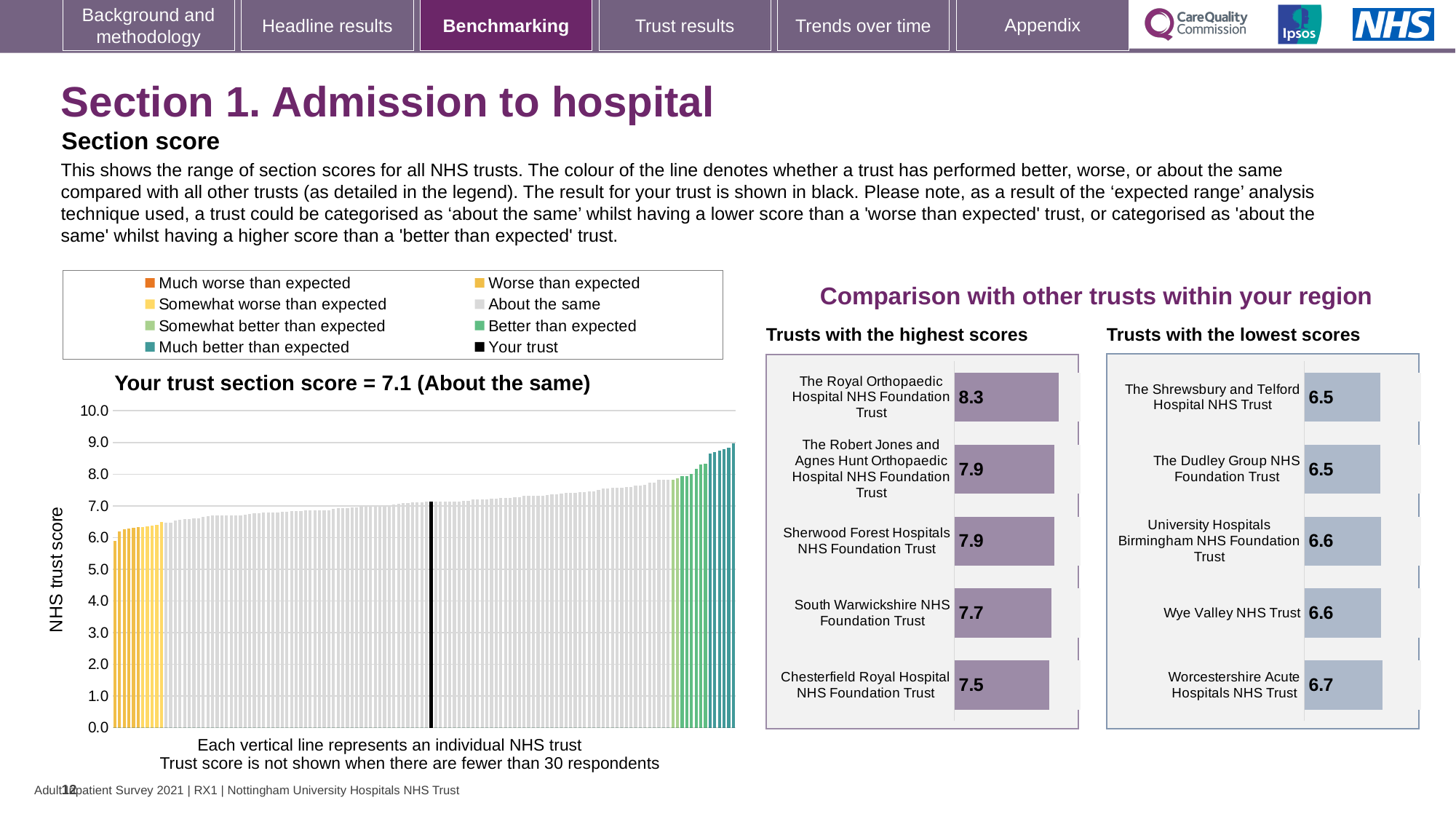
How many entries does the legend above the 'Your trust section score' chart list? 8 On the 'Your trust section score' chart, is the value of the rightmost (highest) bar greater or less than 8.0? greater On the 'Trusts with the highest scores' chart, what is the difference between the scores of The Royal Orthopaedic Hospital NHS Foundation Trust and Chesterfield Royal Hospital NHS Foundation Trust? 0.8 On the 'Trusts with the highest scores' chart, which trust has the lowest score? Chesterfield Royal Hospital NHS Foundation Trust On the 'Your trust section score' chart, what is the section score for your trust? 7.1 On the 'Trusts with the lowest scores' chart, which has the larger score: Worcestershire Acute Hospitals NHS Trust or The Dudley Group NHS Foundation Trust? Worcestershire Acute Hospitals NHS Trust How many trusts are shown on the 'Trusts with the highest scores' chart? 5 On the 'Trusts with the lowest scores' chart, which trust has the highest score? Worcestershire Acute Hospitals NHS Trust On the 'Your trust section score' chart, do the bars rise or fall from left to right? rise On the 'Trusts with the highest scores' chart, what is the score for The Royal Orthopaedic Hospital NHS Foundation Trust? 8.3 On the 'Trusts with the lowest scores' chart, what is the score for Wye Valley NHS Trust? 6.6 What kind of chart is the 'Your trust section score' chart on the left of the slide? bar chart